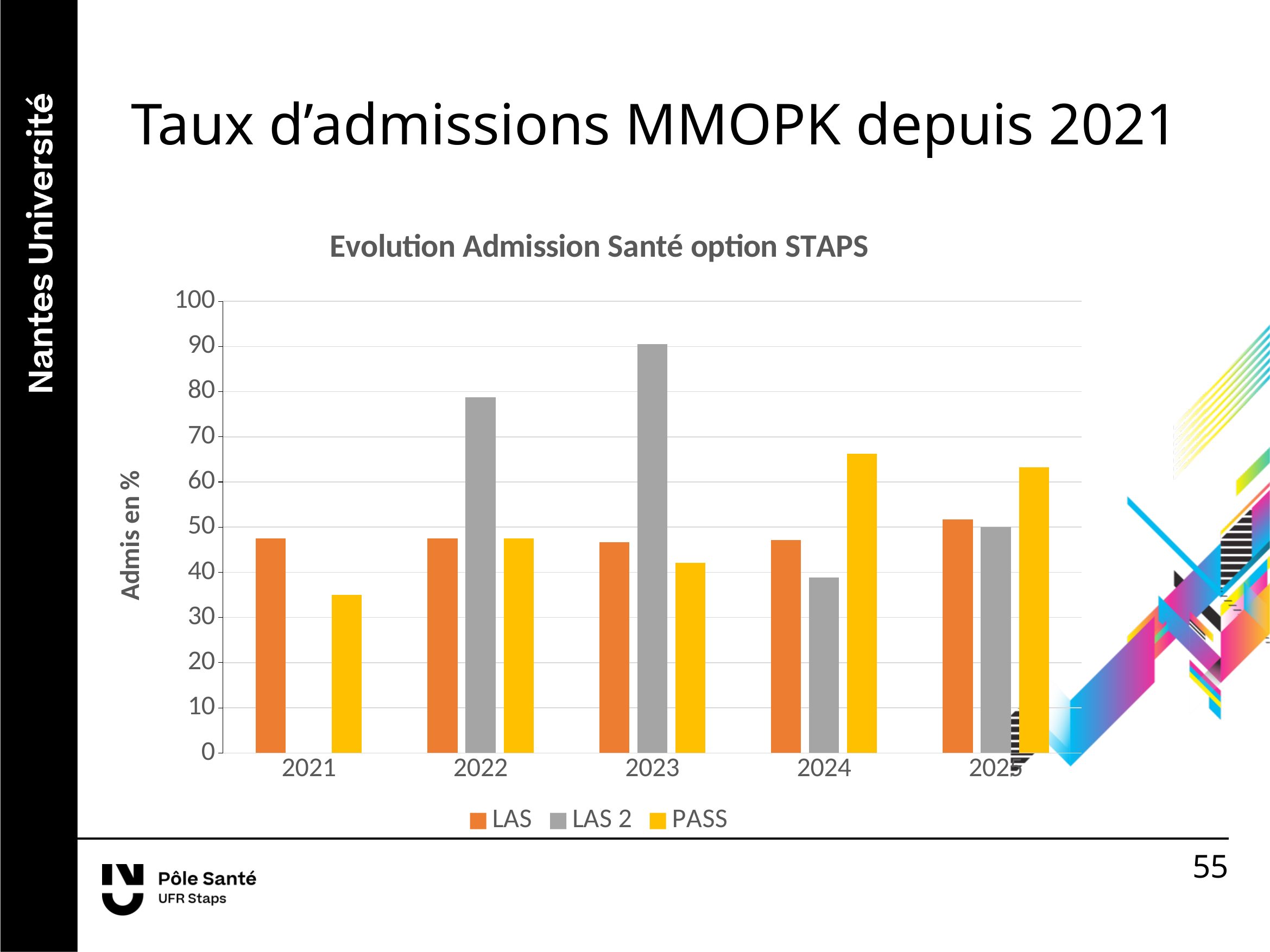
What kind of chart is shown on the slide? bar chart In which year is the LAS 2 value lowest? 2024 Is the value for LAS 2 in 2023 greater or less than 80? greater How many years are shown on the x axis? 5 Does the LAS 2 value rise or fall from 2023 to 2024? fall In 2024, which is larger: PASS or LAS 2? PASS What is the title of the chart? Evolution Admission Santé option STAPS Is the value for PASS in 2021 greater or less than 40? less Is the value for PASS in 2024 greater or less than 60? greater In which year is the PASS value lowest? 2021 How many series does the legend list? 3 In which year is the LAS 2 value highest? 2023